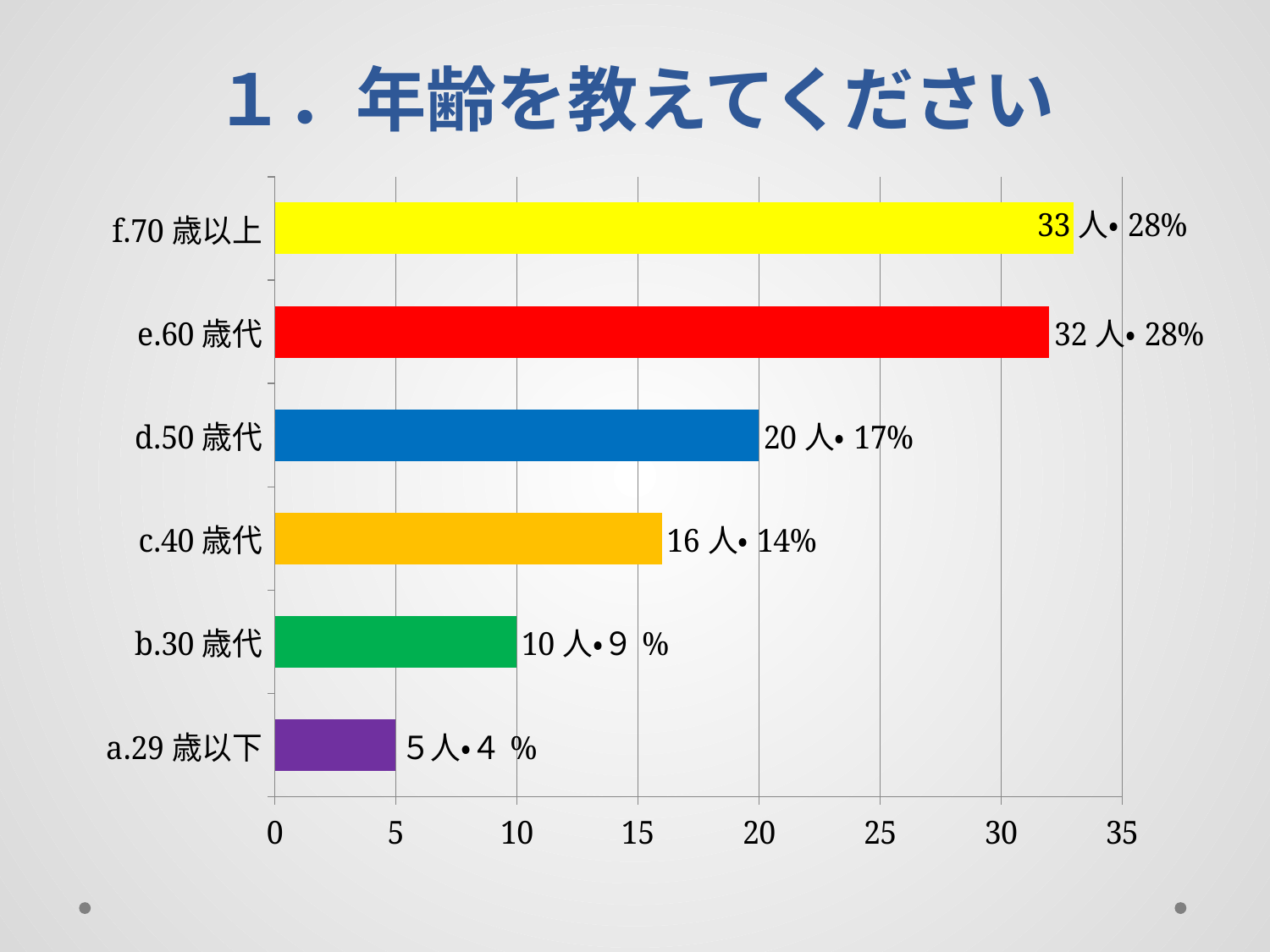
Is the value for c.40歳代 greater or less than 15? greater How many people are in the b.30歳代 category? 10人 Which age category has the lowest count? a.29歳以下 What percentage is shown for d.50歳代? 17% What kind of chart is shown on the slide? Bar chart What colour is the bar for e.60歳代? Red Which age category has the highest count? f.70歳以上 Which has more people, e.60歳代 or d.50歳代? e.60歳代 What is the difference in the number of people between d.50歳代 and c.40歳代? 4人 How many people are in the f.70歳以上 category? 33人 What is the title of the slide? １．年齢を教えてください How many age categories are shown in the chart? 6